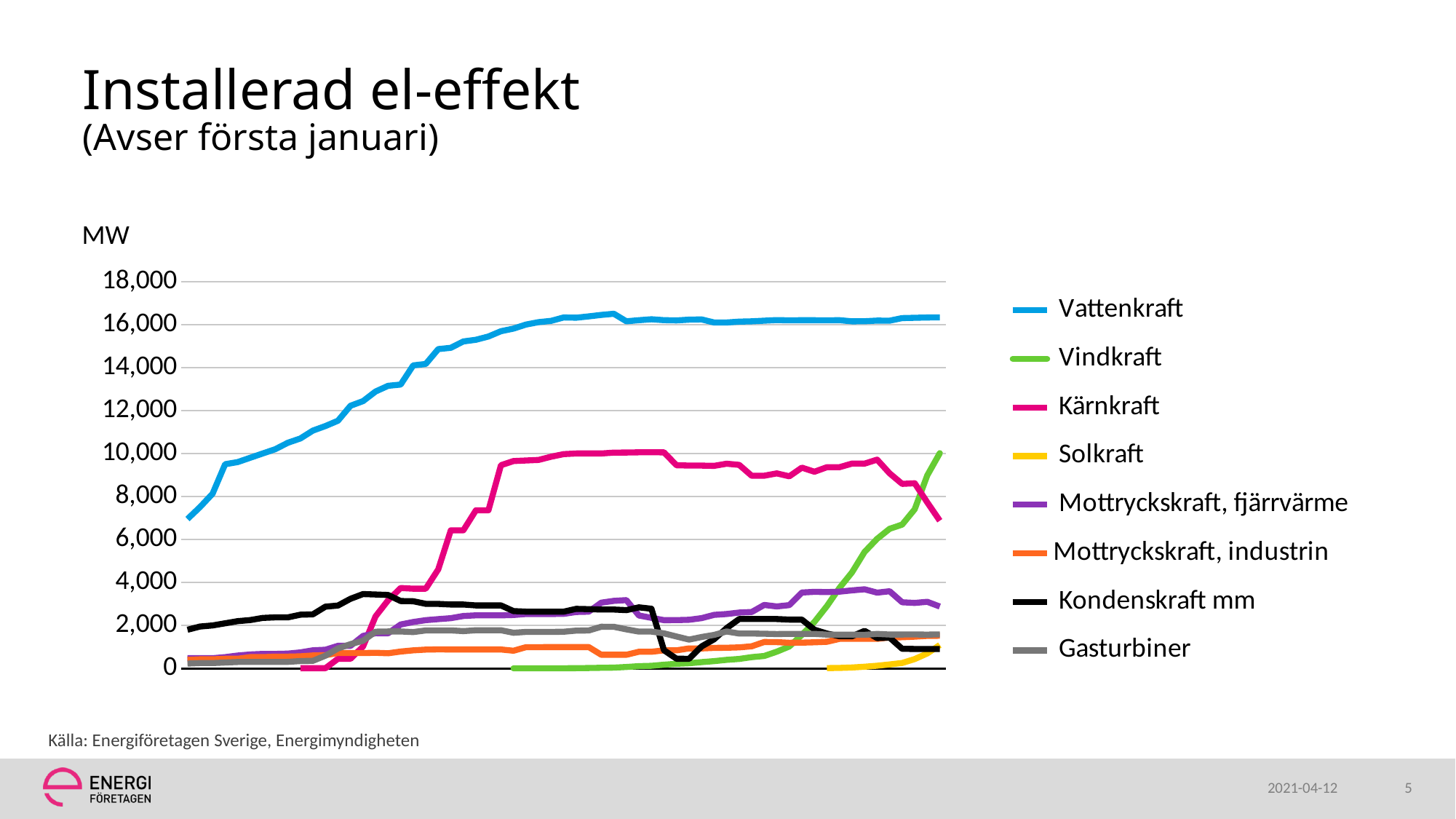
Which series is the last to appear along the x axis? Solkraft Which series has the highest values across the whole chart? Vattenkraft Does the Kärnkraft line rise or fall at the right-hand end of the chart? fall Does the Vattenkraft line rise or fall overall from left to right? rise Is the value for Vattenkraft at the left-hand start of the chart greater or less than 8,000? less At the right-hand end of the chart, which is larger: Vindkraft or Kärnkraft? Vindkraft How many series does the legend list? 8 What unit is shown on the y axis? MW Is the value for Vattenkraft at the right-hand end of the chart greater or less than 14,000? greater What kind of chart is shown on the slide? line chart Is the value for Kärnkraft at the right-hand end of the chart greater or less than 8,000? less